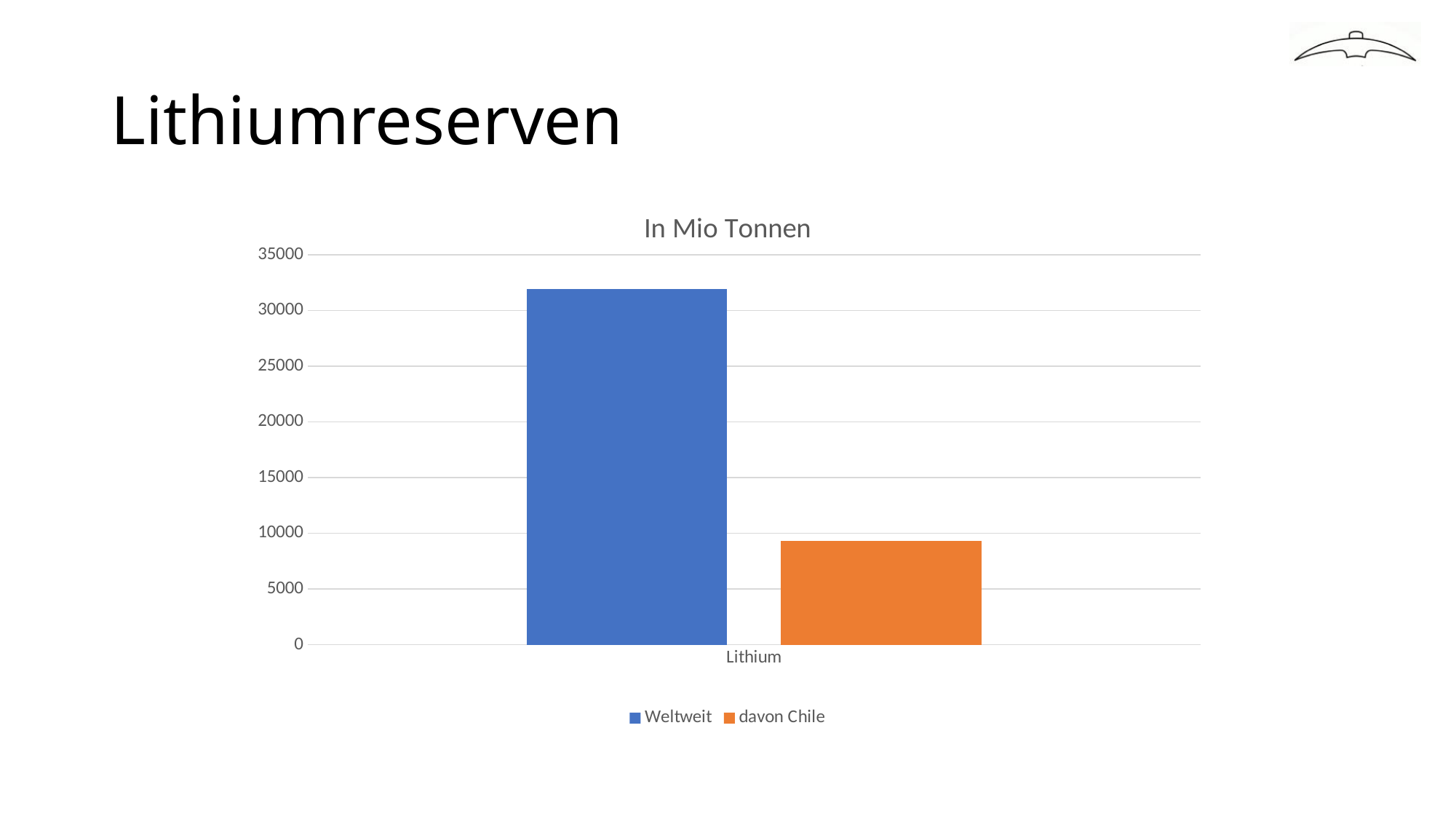
What is the label of the category on the x axis? Lithium Is the value for Weltweit greater or less than 35000? less Which series is shown in orange? davon Chile Is the value for davon Chile greater or less than 10000? less How many categories are shown on the x axis? 1 Which series has the larger value for Lithium, Weltweit or davon Chile? Weltweit What type of chart is shown on the slide? bar chart What is the title of the chart? In Mio Tonnen How many series does the legend list? 2 Is the value for davon Chile greater or less than 5000? greater Which series has the lowest value in the chart? davon Chile